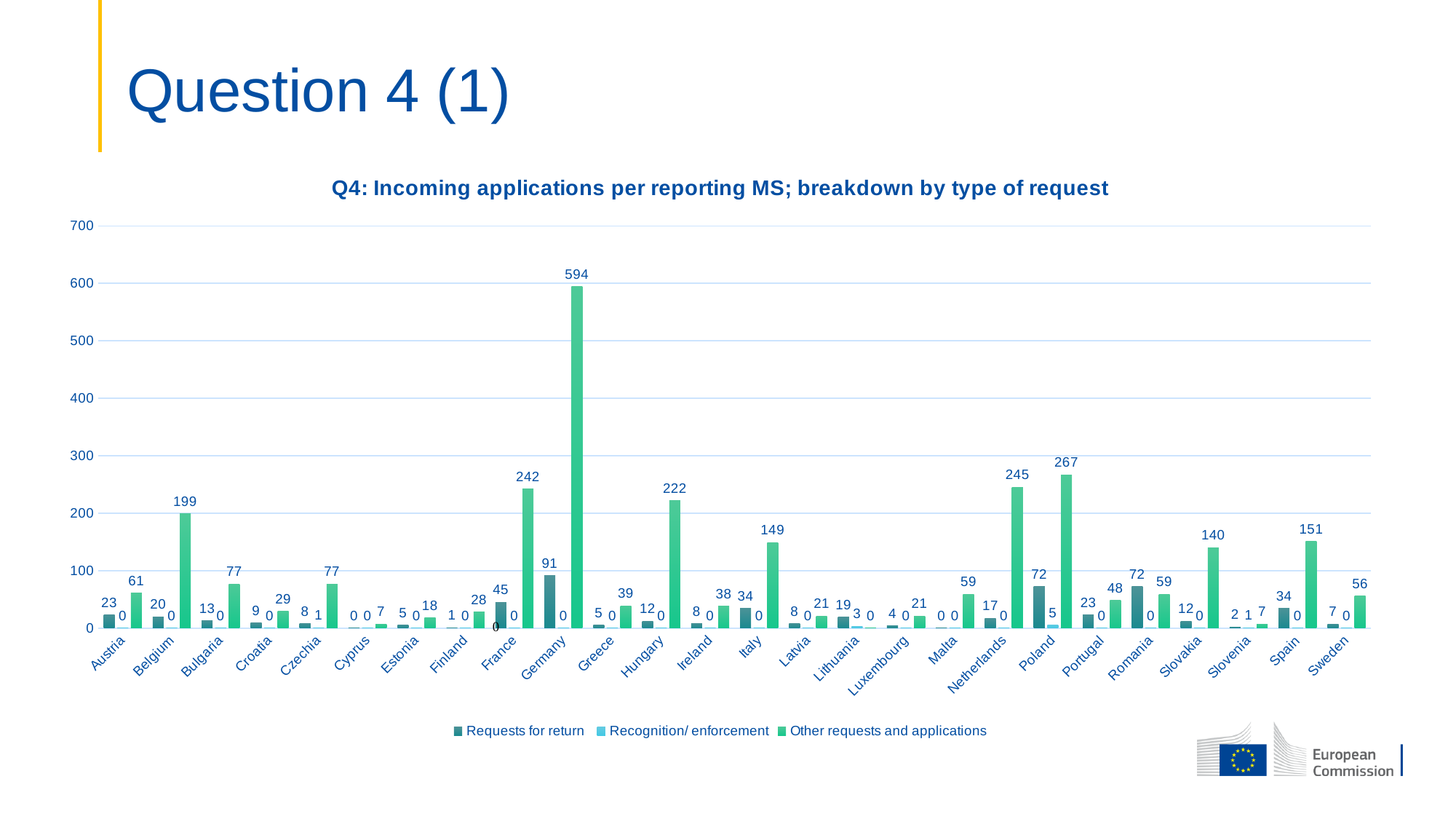
What is the difference between the Other requests and applications values for Poland and the Netherlands? 22 What kind of chart is shown? Bar chart What is the total of the three series for Poland? 344 What is the value of Recognition/ enforcement for Lithuania? 3 How many countries are shown on the x axis? 26 Which country has the highest value for Other requests and applications? Germany What is the value of Requests for return for Poland? 72 What is the title of the chart? Q4: Incoming applications per reporting MS; breakdown by type of request What is the value of Other requests and applications for Germany? 594 Which is larger: Other requests and applications for France or for Hungary? France How many series does the legend list? 3 Which country has the highest value for Requests for return? Germany